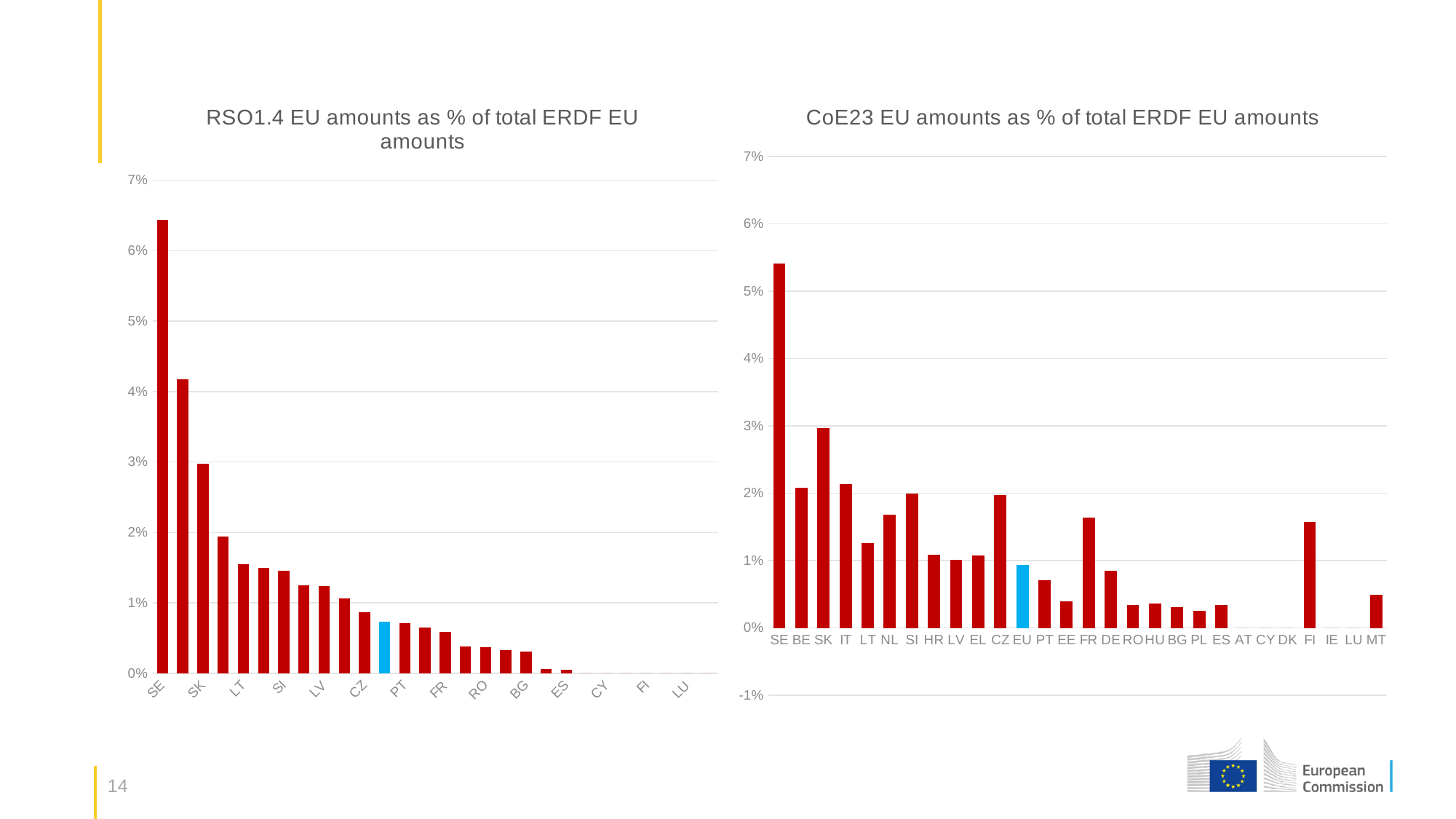
In the right chart, 'CoE23 EU amounts as % of total ERDF EU amounts', which category is shown with a blue bar instead of a red one? EU In the right chart, 'CoE23 EU amounts as % of total ERDF EU amounts', is the value for NL greater or less than 1%? greater In the right chart, 'CoE23 EU amounts as % of total ERDF EU amounts', is the value for SE greater or less than 5%? greater In the right chart, 'CoE23 EU amounts as % of total ERDF EU amounts', is the value for MT greater or less than 1%? less In the right chart, 'CoE23 EU amounts as % of total ERDF EU amounts', which is larger, the value for FI or the value for MT? FI How many countries/categories are shown on the x axis of the right chart, 'CoE23 EU amounts as % of total ERDF EU amounts'? 28 In the right chart, 'CoE23 EU amounts as % of total ERDF EU amounts', which country has the highest value? SE In the left chart, 'RSO1.4 EU amounts as % of total ERDF EU amounts', which country has the highest value? SE In the right chart, 'CoE23 EU amounts as % of total ERDF EU amounts', which is larger, the value for SI or the value for HR? SI What kind of chart is the left chart, 'RSO1.4 EU amounts as % of total ERDF EU amounts'? bar chart